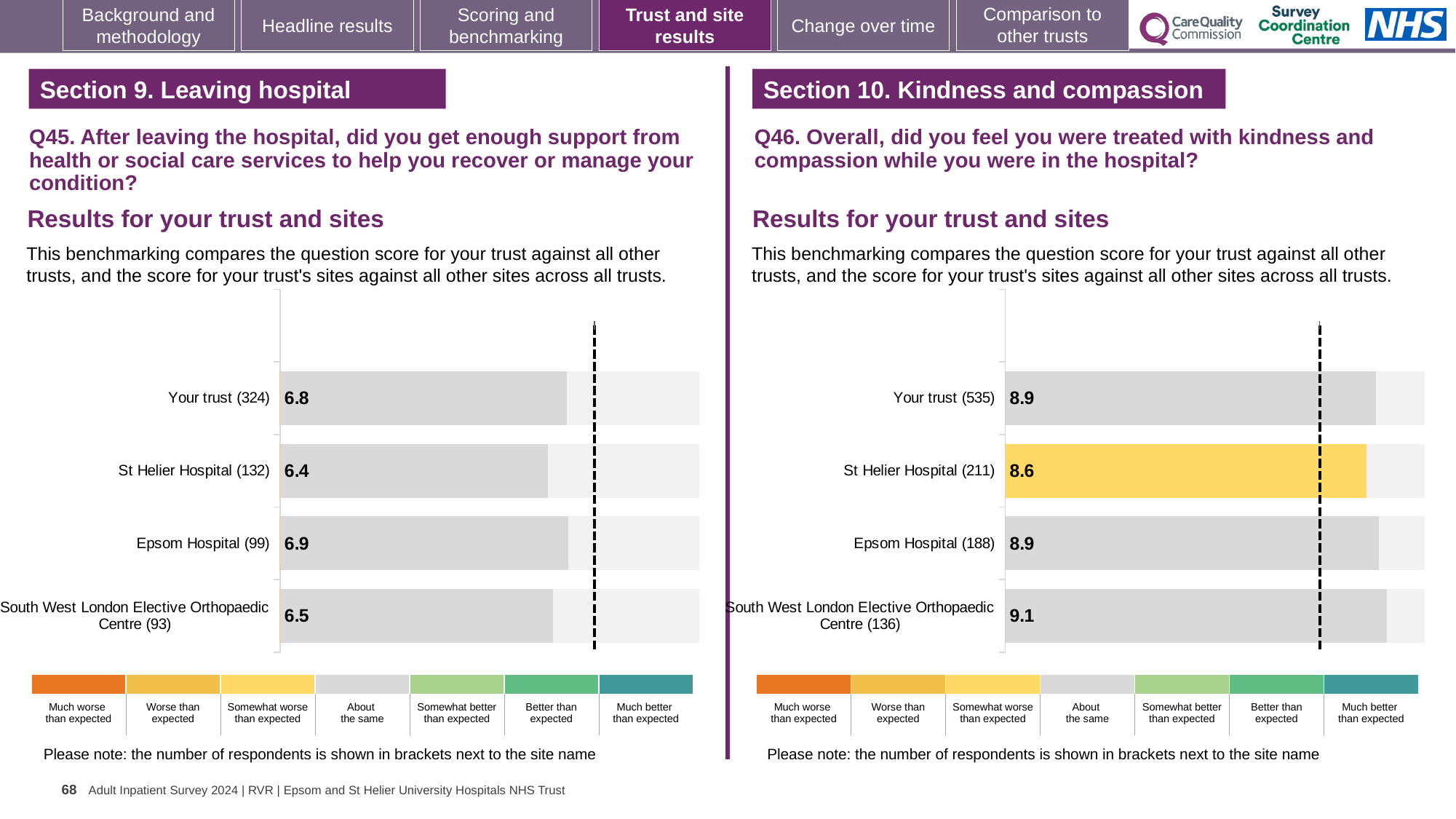
On the Q46 chart (right), which site or trust has the lowest score? St Helier Hospital On the Q45 chart (left), which site or trust has the highest score? Epsom Hospital On the Q46 chart (right), what is the difference between the scores for South West London Elective Orthopaedic Centre and St Helier Hospital? 0.5 On the Q46 chart (right), what is the score for St Helier Hospital? 8.6 On the Q45 chart (left), which site or trust has the lowest score? St Helier Hospital On the Q45 chart (left), what is the difference between the scores for Epsom Hospital and South West London Elective Orthopaedic Centre? 0.4 On the Q45 chart (left), what is the score for St Helier Hospital? 6.4 On the Q45 chart (left), what is the score for Your trust? 6.8 On the Q45 chart (left), how many bars are plotted? 4 On the Q46 chart (right), which is larger: the score for Your trust or the score for St Helier Hospital? Your trust What kind of chart is used on the Q46 chart (right)? Bar chart On the Q46 chart (right), what is the score for South West London Elective Orthopaedic Centre? 9.1